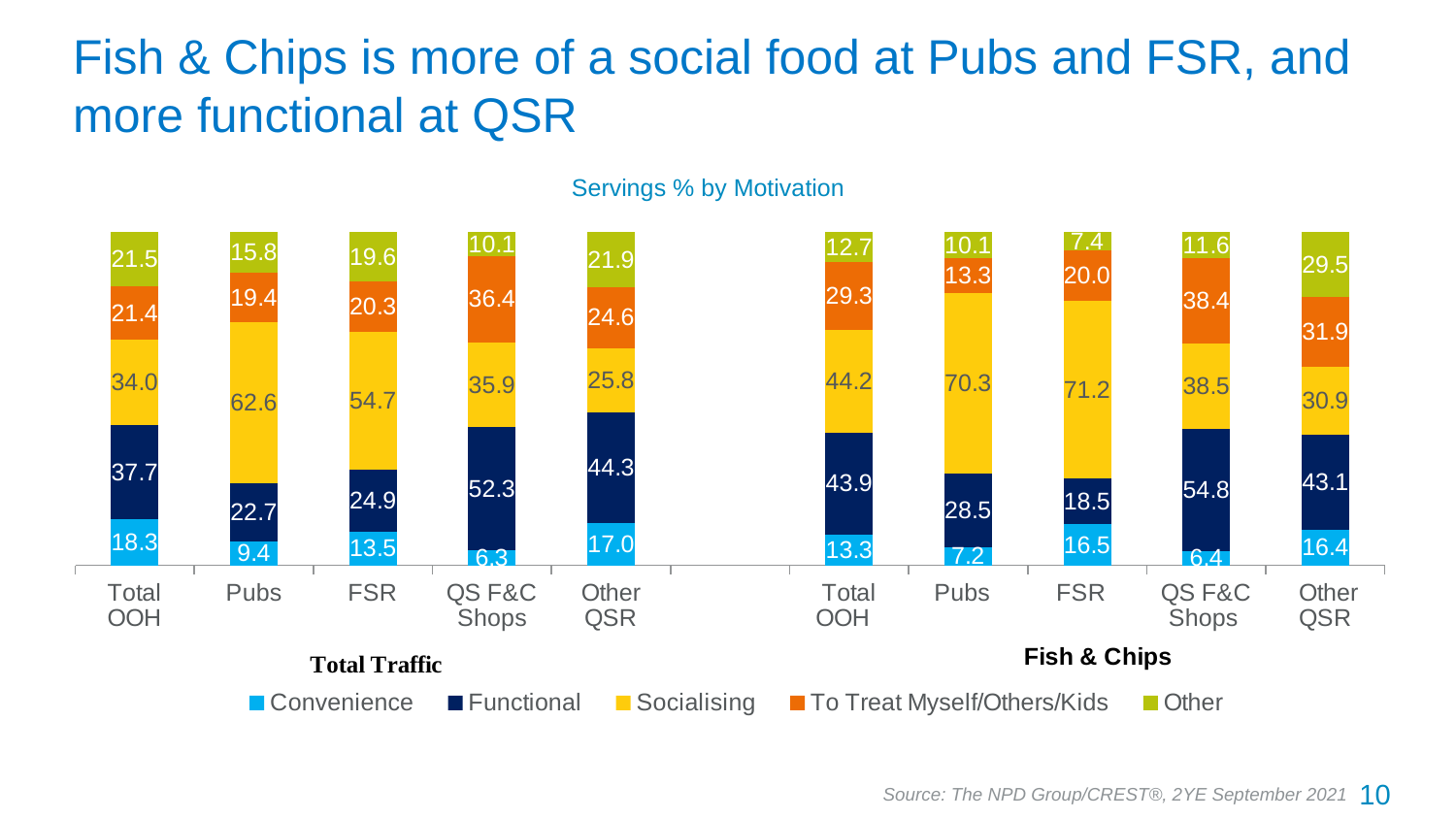
How many categories are shown in the Fish & Chips group? 5 In the Fish & Chips group, what is the Convenience value for FSR? 16.5 In the Fish & Chips group, is the Functional value larger for QS F&C Shops or for Other QSR? QS F&C Shops In the Fish & Chips group, what is the Socialising value for Pubs? 70.3 In the Total Traffic group, what is the Functional value for QS F&C Shops? 52.3 In the Total Traffic group, which category has the lowest Convenience value? QS F&C Shops What kind of chart is shown on the slide? Stacked bar chart What is the difference between the Socialising value for Pubs in the Fish & Chips group and the Socialising value for Pubs in the Total Traffic group? 7.7 How many series does the legend list? 5 In the Total Traffic group, what is the Other value for Other QSR? 21.9 What is the title of the chart? Servings % by Motivation In the Fish & Chips group, which category has the highest Socialising value? FSR